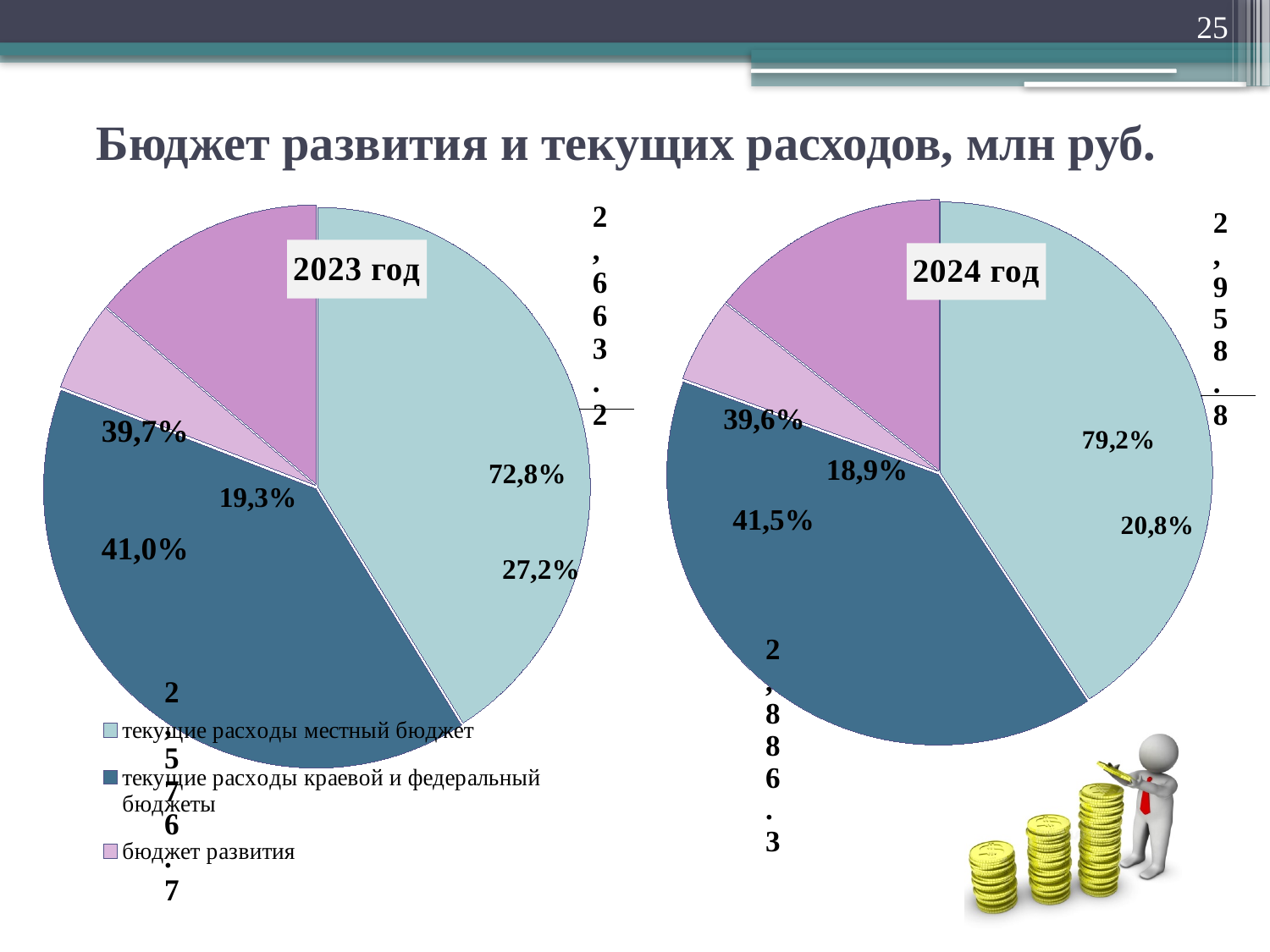
What kind of charts are shown on the slide? Pie charts Which chart, 2023 год or 2024 год, shows the label 41,5%? 2024 год How many entries does the legend list? 3 Which year does the left pie chart represent? 2023 год What value is printed vertically to the right of the 2024 год pie chart? 2,958.8 What value is printed vertically below the 2023 год pie chart? 2,576.7 In the 2023 год pie chart, which colour slice is the smallest? Light pink Which chart, 2023 год or 2024 год, shows the label 72,8%? 2023 год Which is larger, the value 2,958.8 printed beside the 2024 год chart or the value 2,663.2 printed beside the 2023 год chart? 2,958.8 What is the title of the slide's charts? Бюджет развития и текущих расходов, млн руб. What value is printed vertically to the right of the 2023 год pie chart? 2,663.2 What value is printed vertically below the 2024 год pie chart? 2,886.3